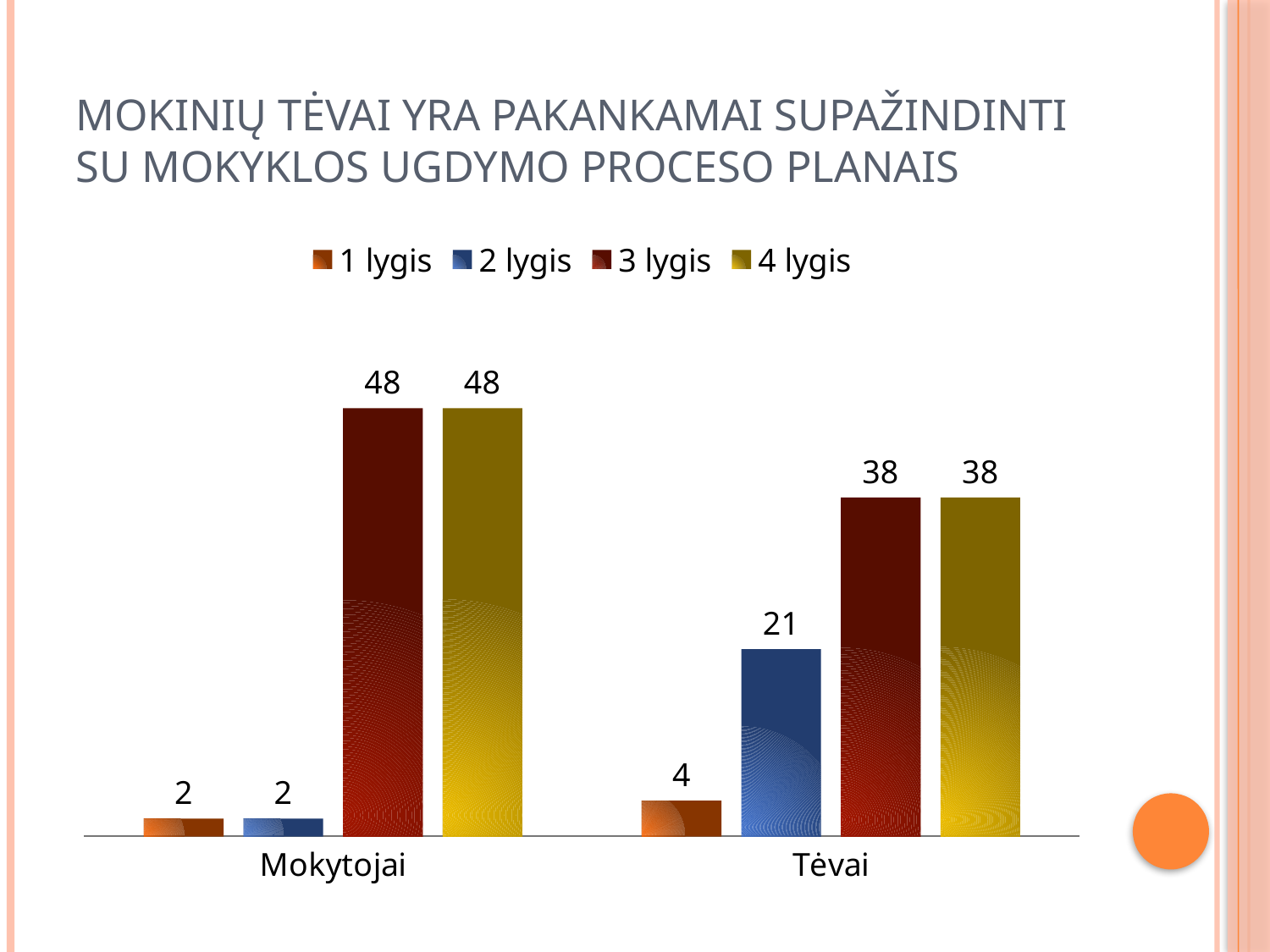
What is the value for 4 lygis in the Mokytojai category? 48 Which series has the lowest value in the Tėvai category? 1 lygis How many categories are shown on the x axis? 2 What kind of chart is shown on the slide? Bar chart What is the value for 3 lygis in the Mokytojai category? 48 What is the difference between the 3 lygis values for Mokytojai and Tėvai? 10 What is the value for 2 lygis in the Tėvai category? 21 Which is larger: the 2 lygis value for Mokytojai or for Tėvai? Tėvai Which is larger: the 4 lygis value for Mokytojai or for Tėvai? Mokytojai What is the value for 1 lygis in the Tėvai category? 4 What is the difference between the 2 lygis values for Tėvai and Mokytojai? 19 How many series does the legend list? 4